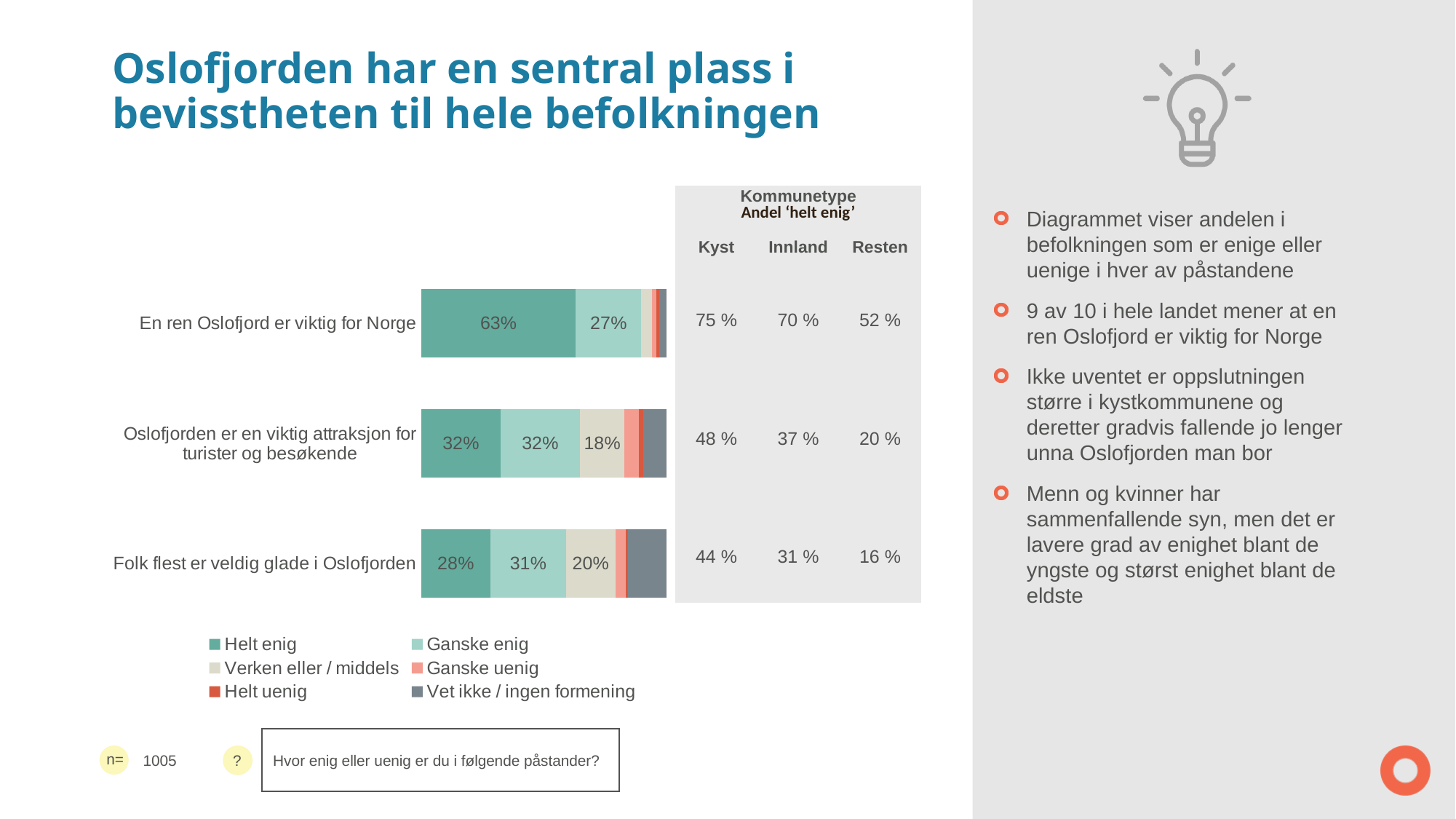
What is the 'Verken eller / middels' share for 'Oslofjorden er en viktig attraksjon for turister og besøkende'? 18% Which legend entry is shown in the darkest grey colour? Vet ikke / ingen formening What is the 'Helt enig' share for 'En ren Oslofjord er viktig for Norge'? 63% What is the 'Helt enig' share for 'Folk flest er veldig glade i Oslofjorden'? 28% What kind of chart is shown on the slide? Stacked bar chart How many series does the legend of the bar chart list? 6 Which statement has the lowest 'Helt enig' share? Folk flest er veldig glade i Oslofjorden What is the difference between the 'Helt enig' share for 'En ren Oslofjord er viktig for Norge' and for 'Oslofjorden er en viktig attraksjon for turister og besøkende'? 31 percentage points Which statement has the highest 'Helt enig' share? En ren Oslofjord er viktig for Norge How many statements (categories) are plotted in the bar chart? 3 What is the 'Ganske enig' share for 'En ren Oslofjord er viktig for Norge'? 27% Is the 'Ganske enig' share larger for 'Folk flest er veldig glade i Oslofjorden' or for 'En ren Oslofjord er viktig for Norge'? Folk flest er veldig glade i Oslofjorden